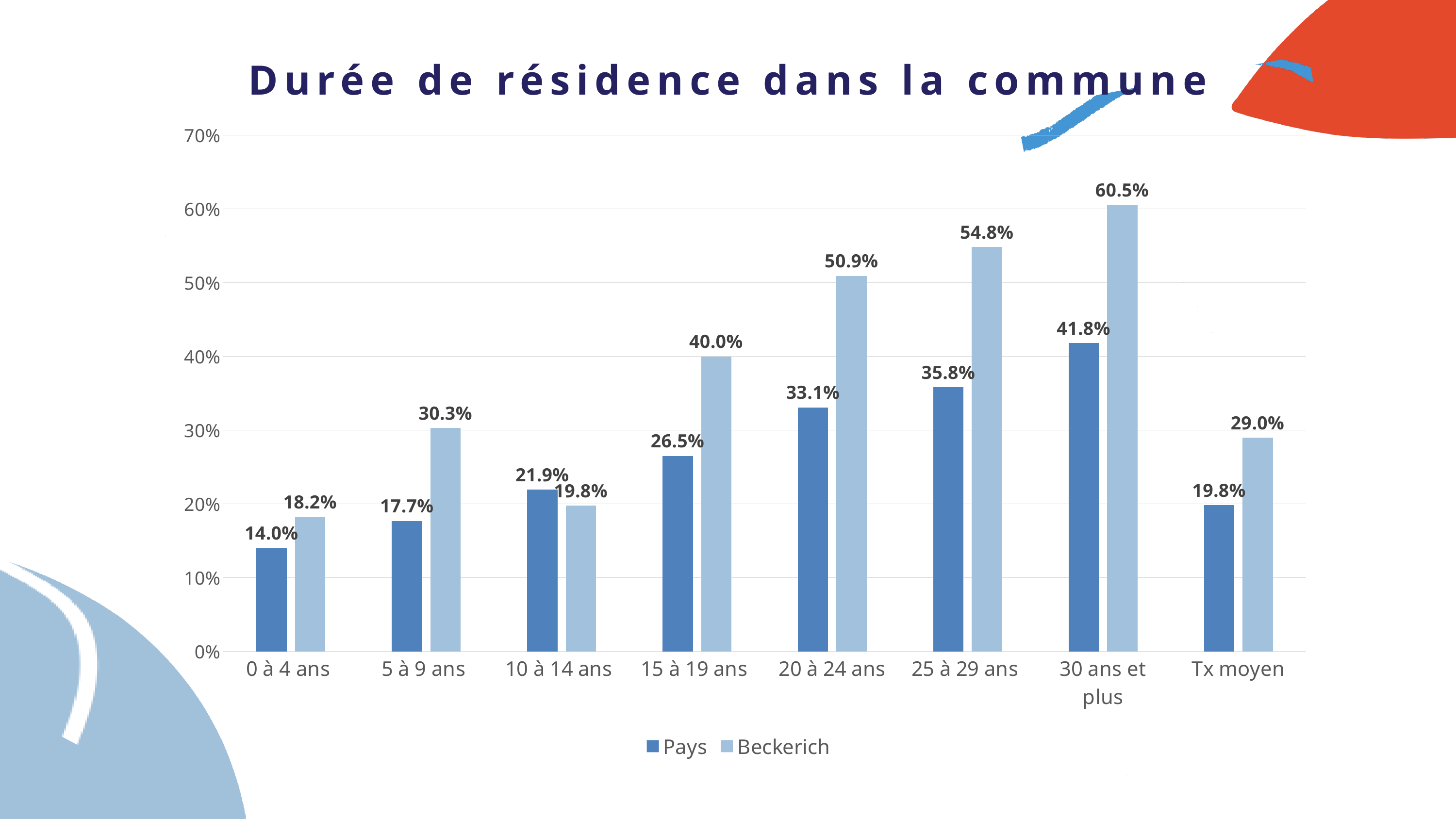
Which category has the highest Beckerich value? 30 ans et plus What is the difference between the Beckerich and Pays values for 20 à 24 ans? 17.8% What is the title of the chart? Durée de résidence dans la commune How many categories are shown on the x axis? 8 For the 10 à 14 ans category, which series has the larger value, Pays or Beckerich? Pays What kind of chart is shown on the slide? bar chart What is the Beckerich value for the 30 ans et plus category? 60.5% What is the Pays value for Tx moyen? 19.8% What is the Pays value for the 15 à 19 ans category? 26.5% Which category has the lowest Pays value? 0 à 4 ans Is the Beckerich value for 25 à 29 ans greater or less than 50%? greater How many series does the legend list? 2